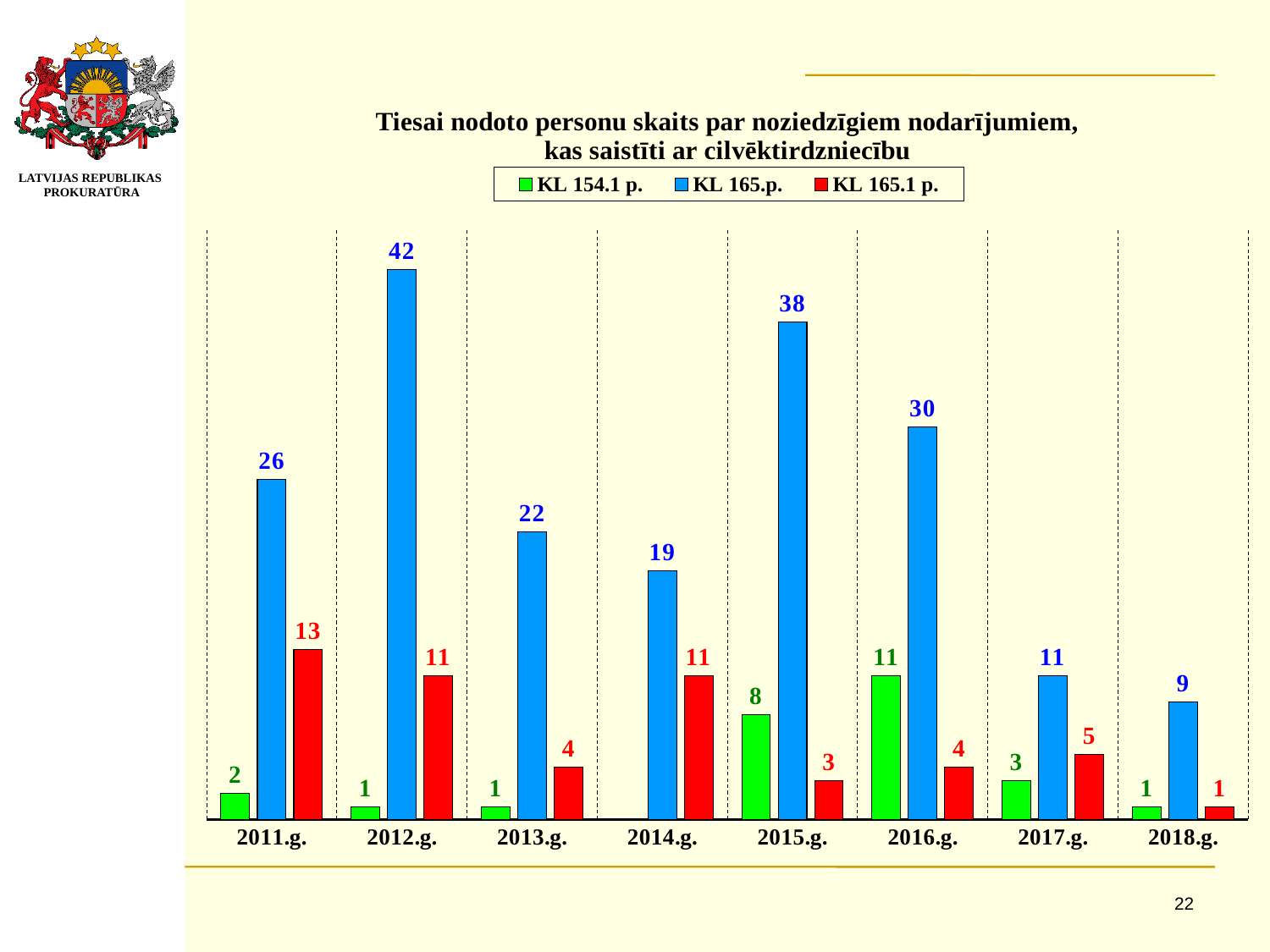
What is the difference between the KL 165.p. values for 2012.g. and 2015.g.? 4 Which is larger, the KL 165.1 p. value for 2011.g. or for 2017.g.? 2011.g. How many series does the legend list? 3 What is the value for KL 165.1 p. in 2011.g.? 13 Which colour represents the KL 165.1 p. series? red What is the value for KL 154.1 p. in 2016.g.? 11 How many years are shown on the x axis? 8 What is the value for KL 165.p. in 2018.g.? 9 What kind of chart is shown on the slide? bar chart In which year is the value for KL 165.p. highest? 2012.g. What is the value for KL 165.p. in 2012.g.? 42 In which year is the value for KL 165.p. lowest? 2018.g.